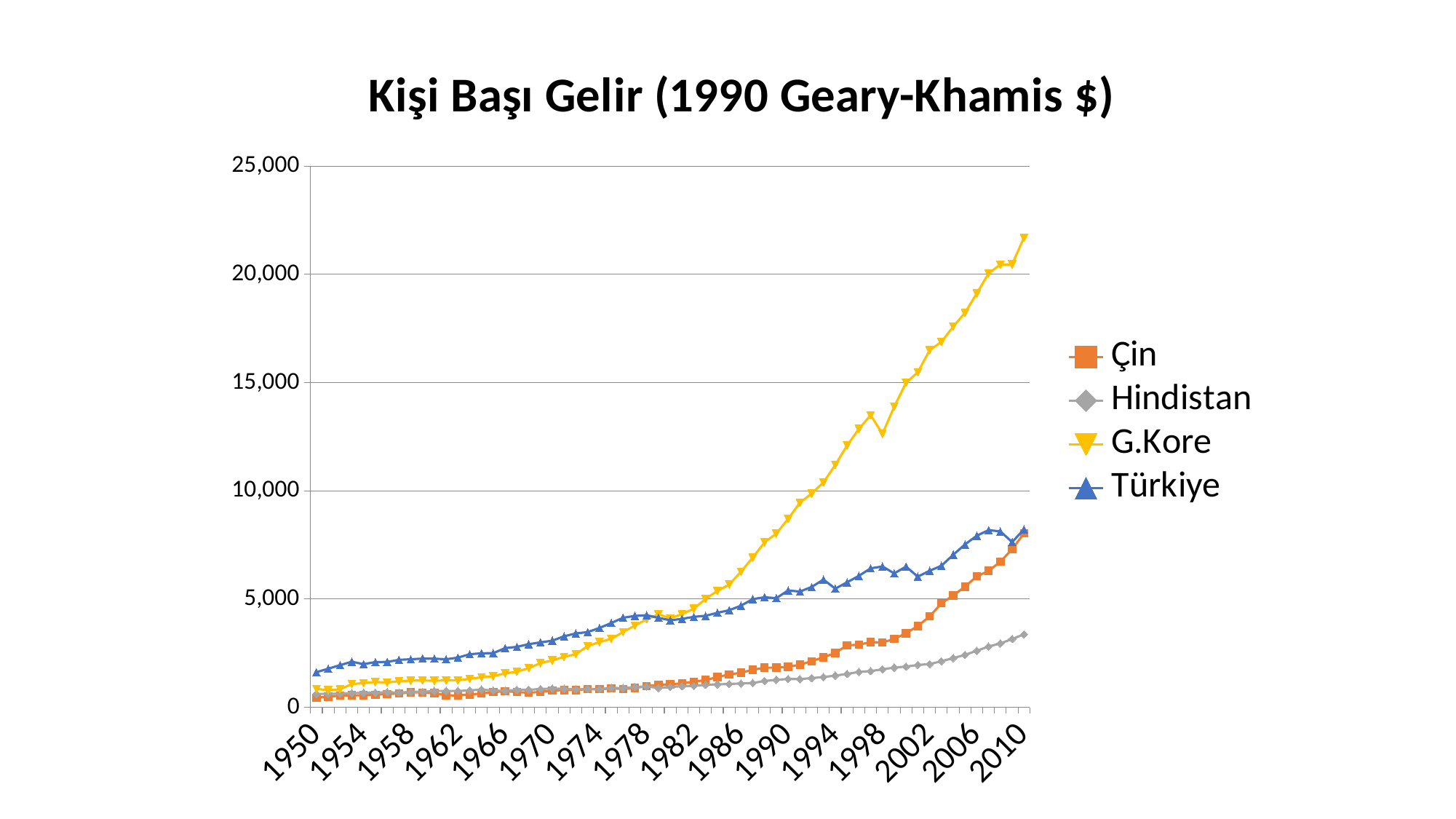
What is the title of the chart? Kişi Başı Gelir (1990 Geary-Khamis $) What kind of chart is shown on the slide? line chart Does the G.Kore series generally rise or fall from 1950 to 2010? rise Is the value for Türkiye in 1950 greater or less than 5,000? less Which series has the highest value in 1950? Türkiye In 1950, which is larger: the value for Türkiye or the value for G.Kore? Türkiye Which series has the highest value in 2010? G.Kore Is the value for G.Kore in 2010 greater or less than 20,000? greater Which series is represented by the yellow line with triangle markers? G.Kore Which series has the lowest value in 2010? Hindistan Is the value for Hindistan in 2010 greater or less than 5,000? less How many series does the legend list? 4